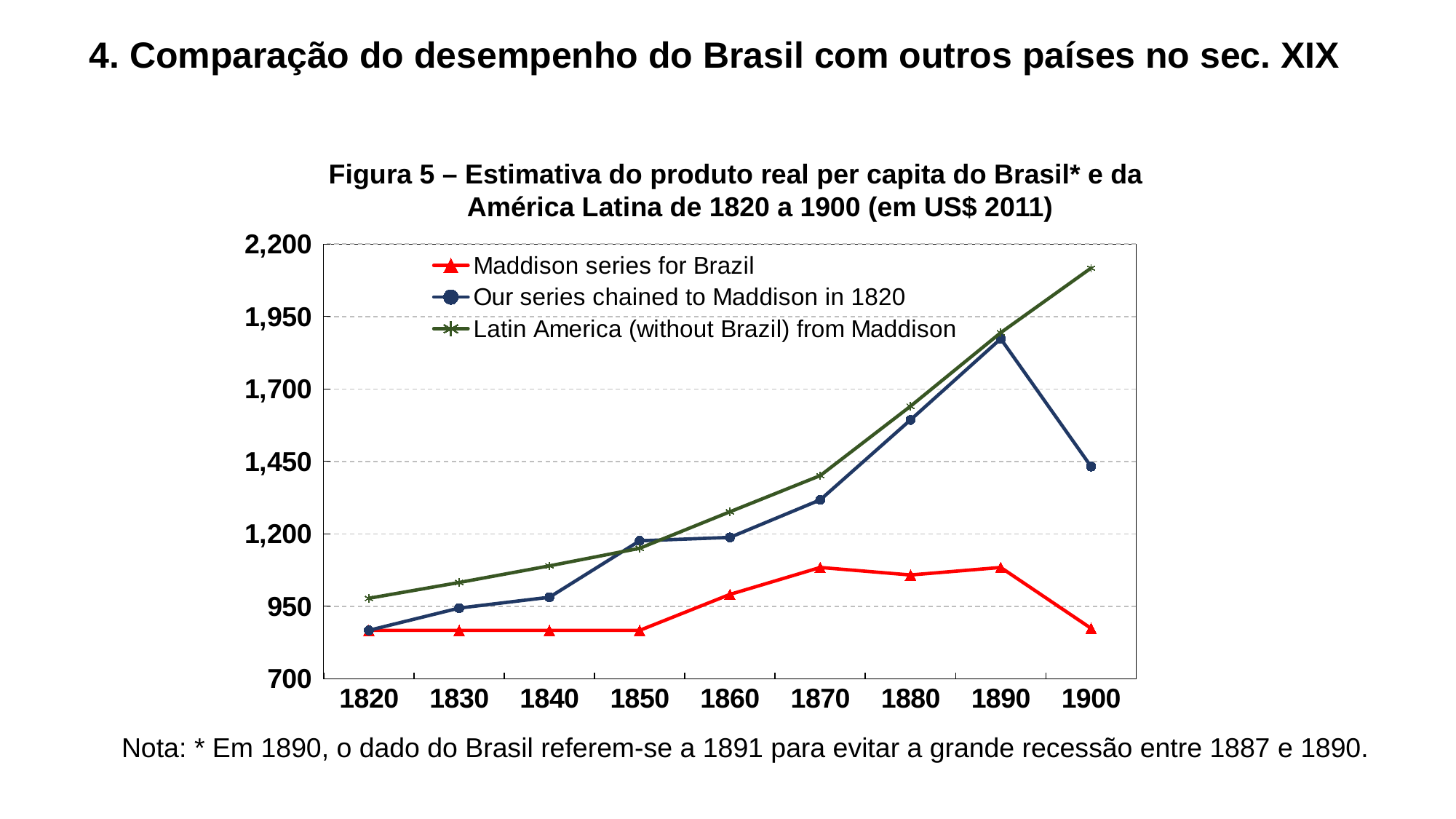
Is the value for 'Maddison series for Brazil' in 1870 greater or less than 1,200? less How many years are marked along the x axis of the chart? 9 In which year does 'Latin America (without Brazil) from Maddison' reach its highest value? 1900 In 1900, which series has the lowest value? Maddison series for Brazil Is the value for 'Latin America (without Brazil) from Maddison' in 1900 greater or less than 1,950? greater In which year does 'Our series chained to Maddison in 1820' reach its highest value? 1890 How many series does the legend of the chart list? 3 What kind of chart is shown in Figura 5? line chart Which series is drawn with red triangle markers? Maddison series for Brazil Is the value for 'Maddison series for Brazil' in 1820 greater or less than 950? less Does the 'Latin America (without Brazil) from Maddison' series rise or fall from 1820 to 1900? rise